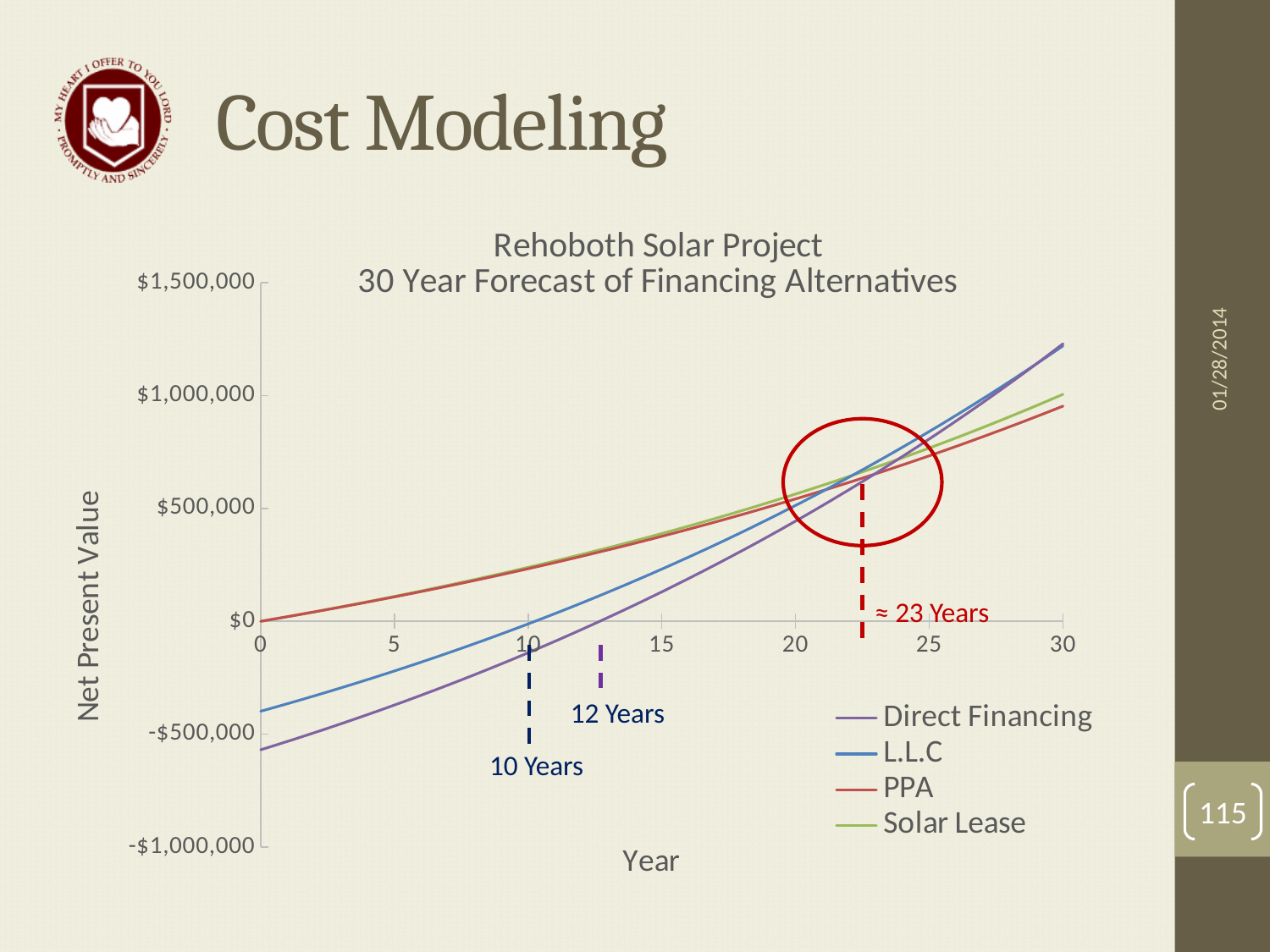
Which series has the lowest Net Present Value at year 0? Direct Financing What is the title of the chart? Rehoboth Solar Project 30 Year Forecast of Financing Alternatives How many series does the chart legend list? 4 Is the value for PPA at year 30 greater or less than $1,000,000? less According to the annotation, at approximately what year do the financing alternatives cross over in the circled region? ≈ 23 Years What kind of chart is shown on the slide? line chart What is the Net Present Value of PPA at year 0? $0 Does the Net Present Value for L.L.C rise or fall as the year increases? rise At year 30, which is higher: Direct Financing or PPA? Direct Financing Is the value for L.L.C at year 0 greater or less than -$500,000? greater Is the value for Direct Financing at year 30 greater or less than $1,000,000? greater